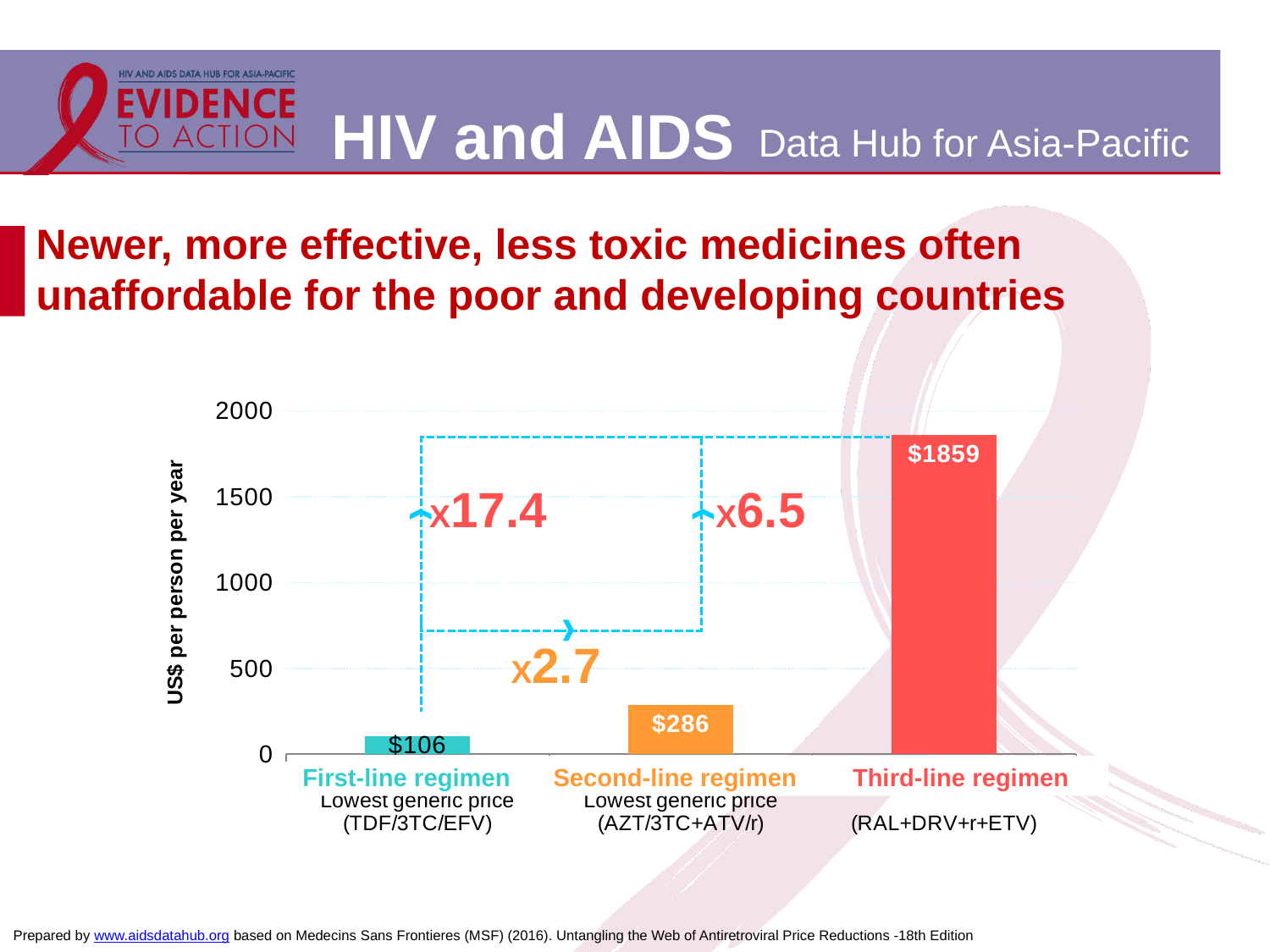
Which is larger, the value for the Second-line regimen or the First-line regimen? Second-line regimen Which regimen has the highest price per person per year? Third-line regimen What is the difference between the Second-line regimen and the First-line regimen values? $180 What is the label of the vertical axis? US$ per person per year What is the value for the Second-line regimen? $286 What is the difference between the Third-line regimen and the Second-line regimen values? $1573 Is the value for the Third-line regimen greater or less than 1500? greater What is the value for the Third-line regimen? $1859 How many regimens are shown in the chart? 3 Which regimen has the lowest price per person per year? First-line regimen What kind of chart is shown on the slide? bar chart What is the value for the First-line regimen? $106